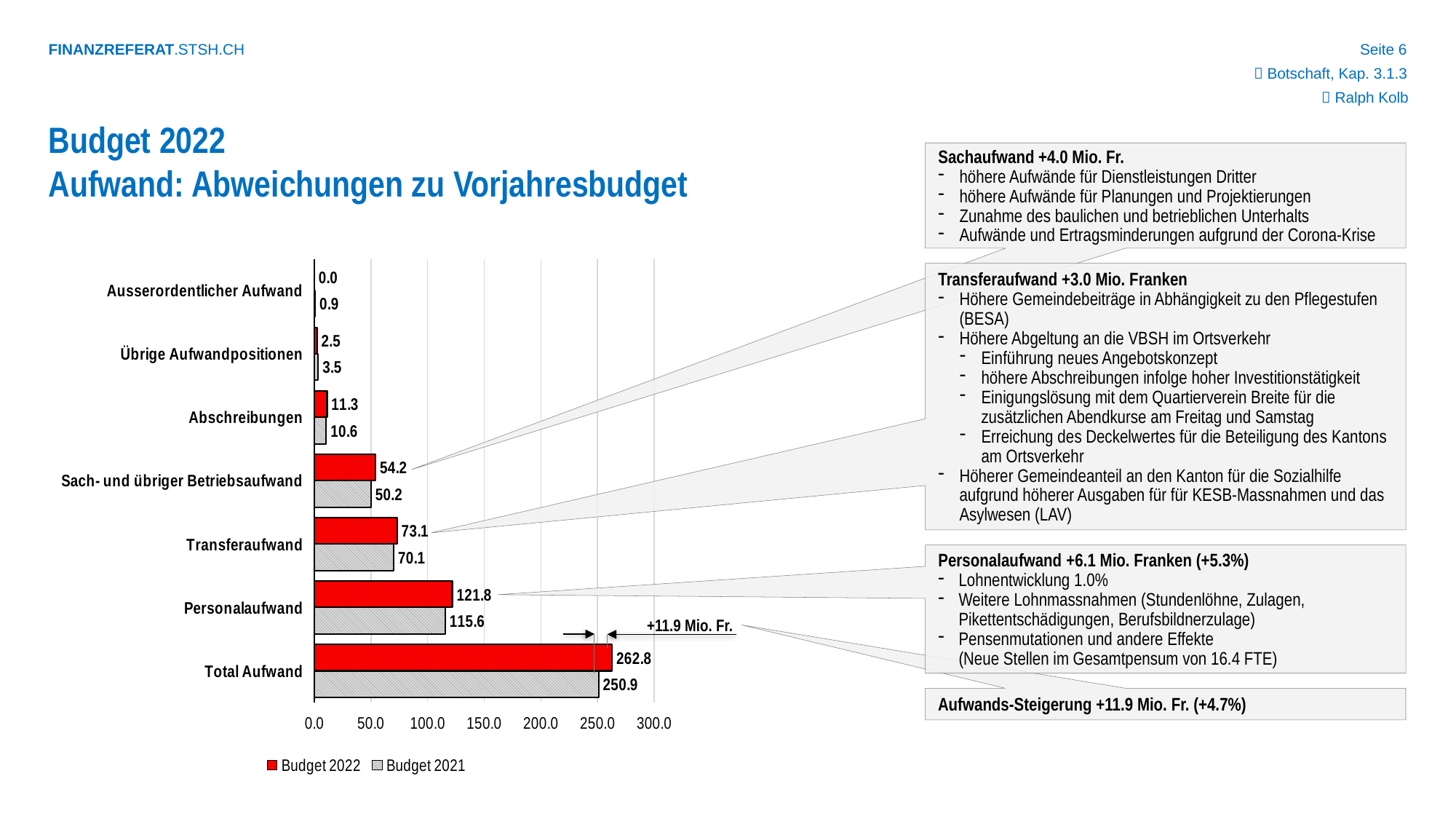
What is the Budget 2022 value for Sach- und übriger Betriebsaufwand? 54.2 Which series is shown in red in the chart? Budget 2022 What kind of chart is shown on the slide? bar chart What is the Budget 2021 value for Transferaufwand? 70.1 What is the Budget 2022 value for Personalaufwand? 121.8 Is the Budget 2022 value for Personalaufwand greater or less than 100.0? greater How many categories are shown on the chart? 7 Which category has the lowest Budget 2022 value? Ausserordentlicher Aufwand Which category has the highest Budget 2022 value? Total Aufwand Which is larger for Abschreibungen: Budget 2022 or Budget 2021? Budget 2022 What is the difference between the Budget 2022 and Budget 2021 values for Total Aufwand? 11.9 How many series does the legend list? 2